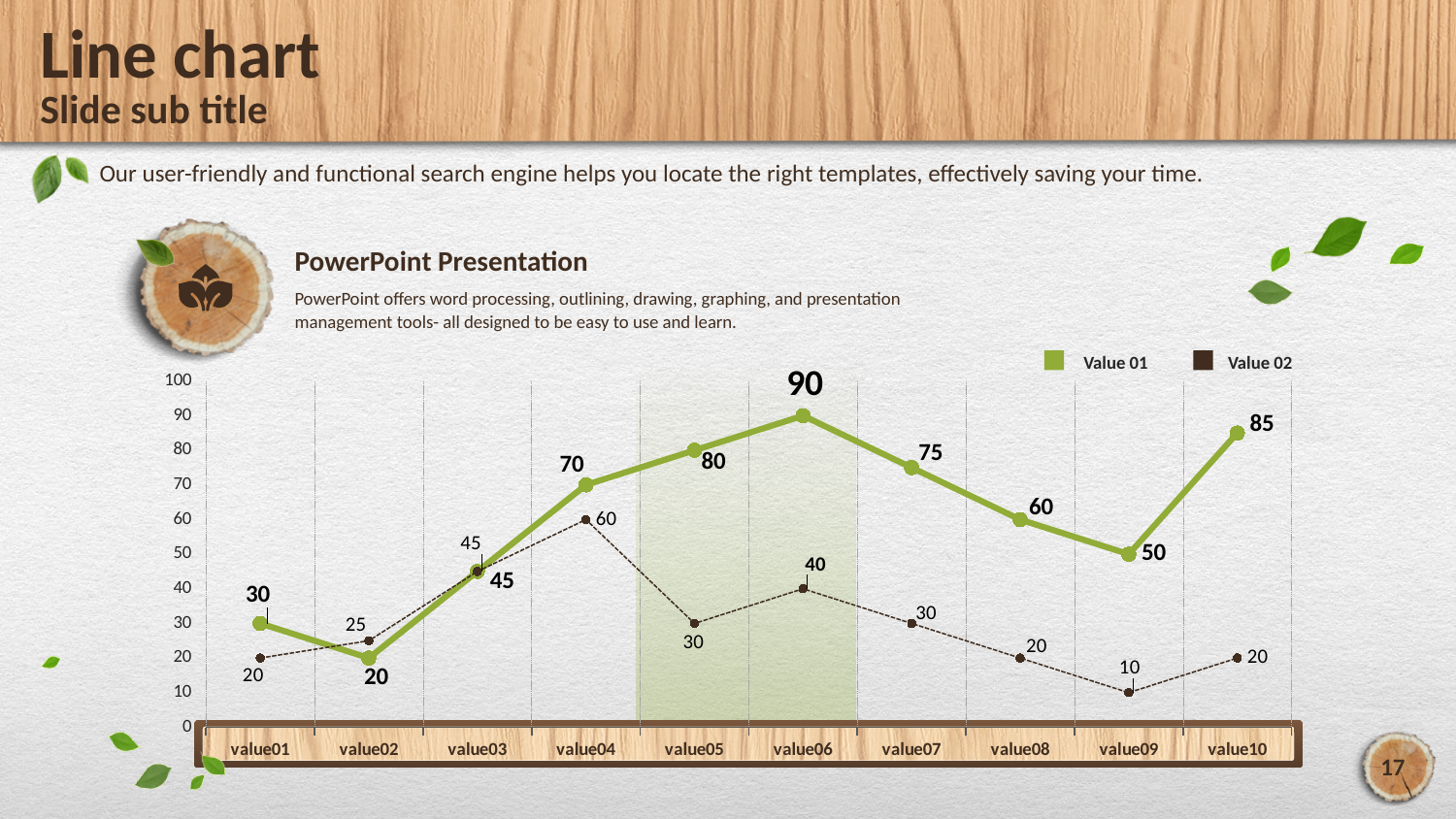
What is the value of Value 01 at value10? 85 How many series does the legend list? 2 Which category has the lowest value for Value 02? value09 What is the difference between Value 01 and Value 02 at value05? 50 What is the value of Value 01 at value06? 90 Which is larger at value02, Value 01 or Value 02? Value 02 Does Value 01 rise or fall from value06 to value09? fall How many categories are shown on the x axis? 10 What is the value of Value 02 at value04? 60 Which category has the highest value for Value 01? value06 What are the two legend entries of the chart? Value 01 and Value 02 What type of chart is shown on the slide? line chart